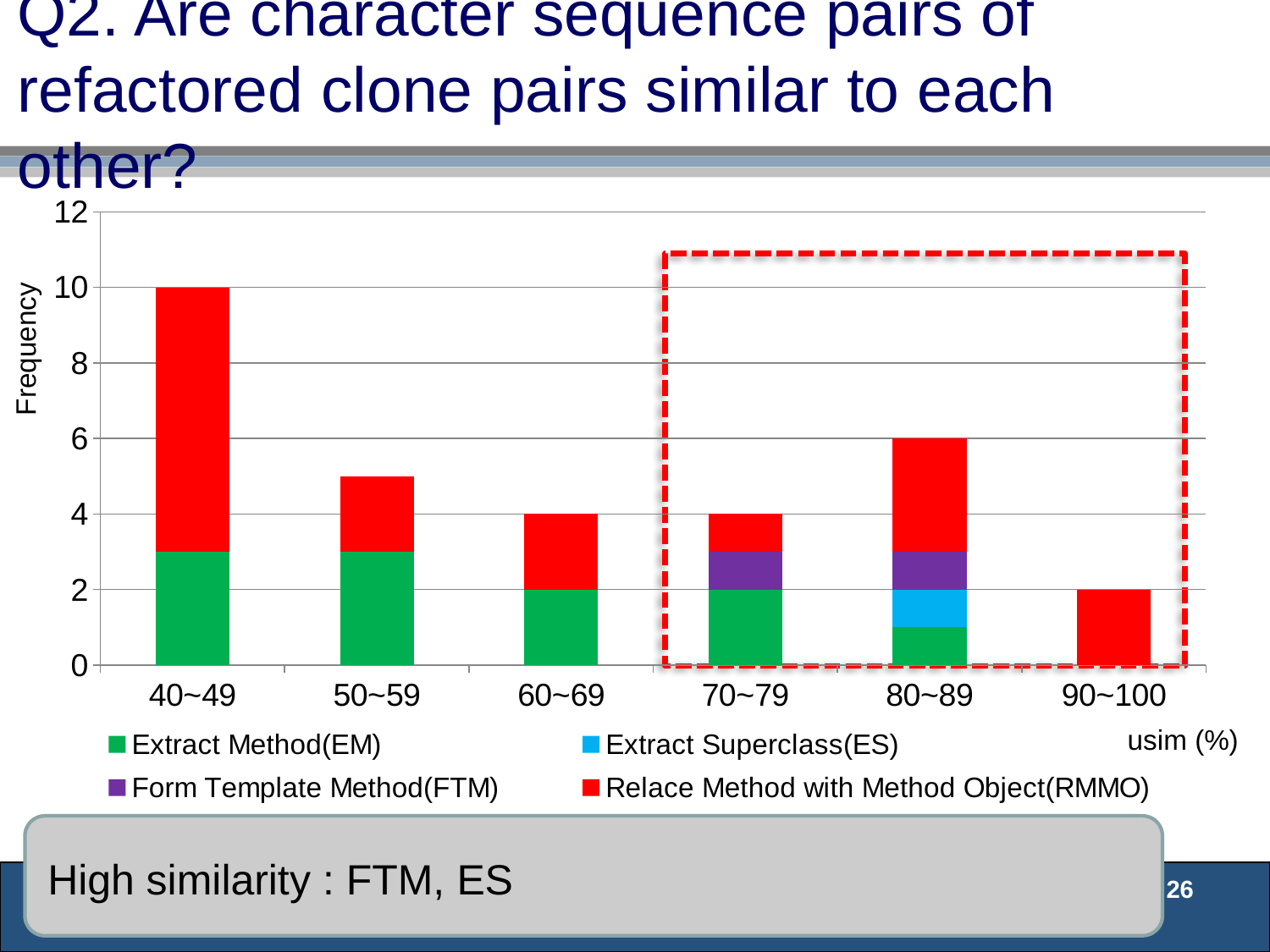
What is the total frequency of the 90~100 bar? 2 Is the total frequency for 50~59 greater or less than 4? greater What kind of chart is shown on the slide? stacked bar chart What is the label of the y axis? Frequency Which has a larger total frequency, 40~49 or 80~89? 40~49 Which usim (%) category has the highest total frequency? 40~49 Which usim (%) category has the lowest total frequency? 90~100 What is the total frequency of the 40~49 bar? 10 How many series does the legend list? 4 What is the difference between the total frequency of 40~49 and that of 80~89? 4 What is the total frequency of the 80~89 bar? 6 How many usim (%) categories are shown on the x axis? 6